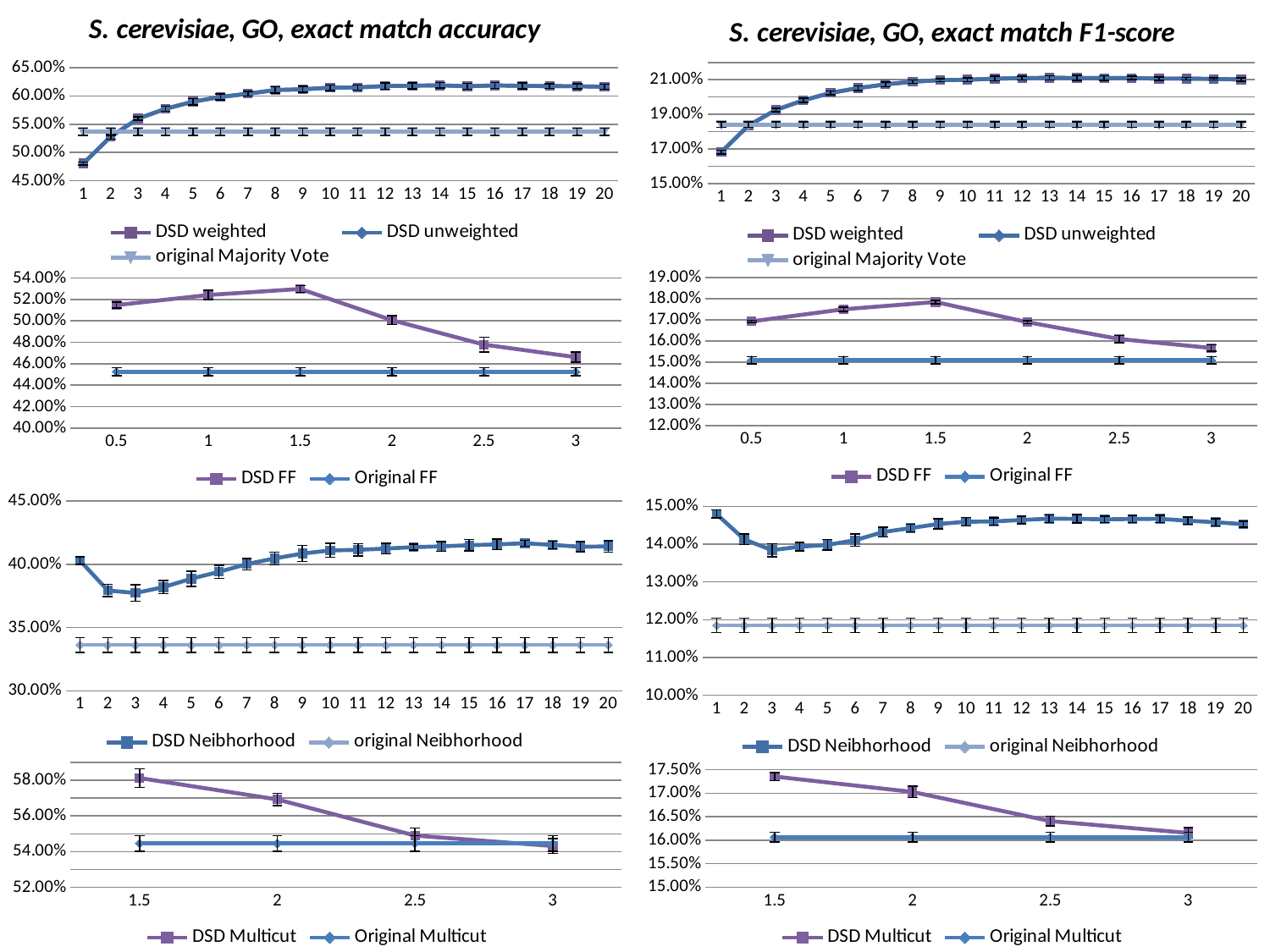
In the top chart of the right column (exact match F1-score), is the value for DSD weighted at x = 20 greater or less than 19.00%? greater In the top chart of the left column (exact match accuracy), is the value for DSD weighted at x = 1 greater or less than 50.00%? less In the third chart of the right column (DSD Neibhorhood vs original Neibhorhood, F1-score), how many x-axis points are plotted? 20 What kind of chart is the top chart in the left column (S. cerevisiae, GO, exact match accuracy)? line chart In the top chart of the left column (exact match accuracy), how many series does the legend list? 3 In the third chart of the left column (DSD Neibhorhood vs original Neibhorhood, accuracy), is the value for DSD Neibhorhood at x = 3 greater or less than 40.00%? less In the bottom chart of the right column (DSD Multicut vs Original Multicut, F1-score), which series has the larger value at x = 1.5? DSD Multicut In the second chart of the left column (DSD FF vs Original FF, accuracy), how many x-axis points are plotted? 6 In the second chart of the left column (DSD FF vs Original FF, accuracy), at which x value is DSD FF lowest? 3 In the bottom chart of the left column (DSD Multicut vs Original Multicut, accuracy), do the DSD Multicut values rise or fall as x increases from 1.5 to 3? fall In the bottom chart of the right column (DSD Multicut vs Original Multicut, F1-score), how many series does the legend list? 2 What is the title shown above the right column of charts? S. cerevisiae, GO, exact match F1-score